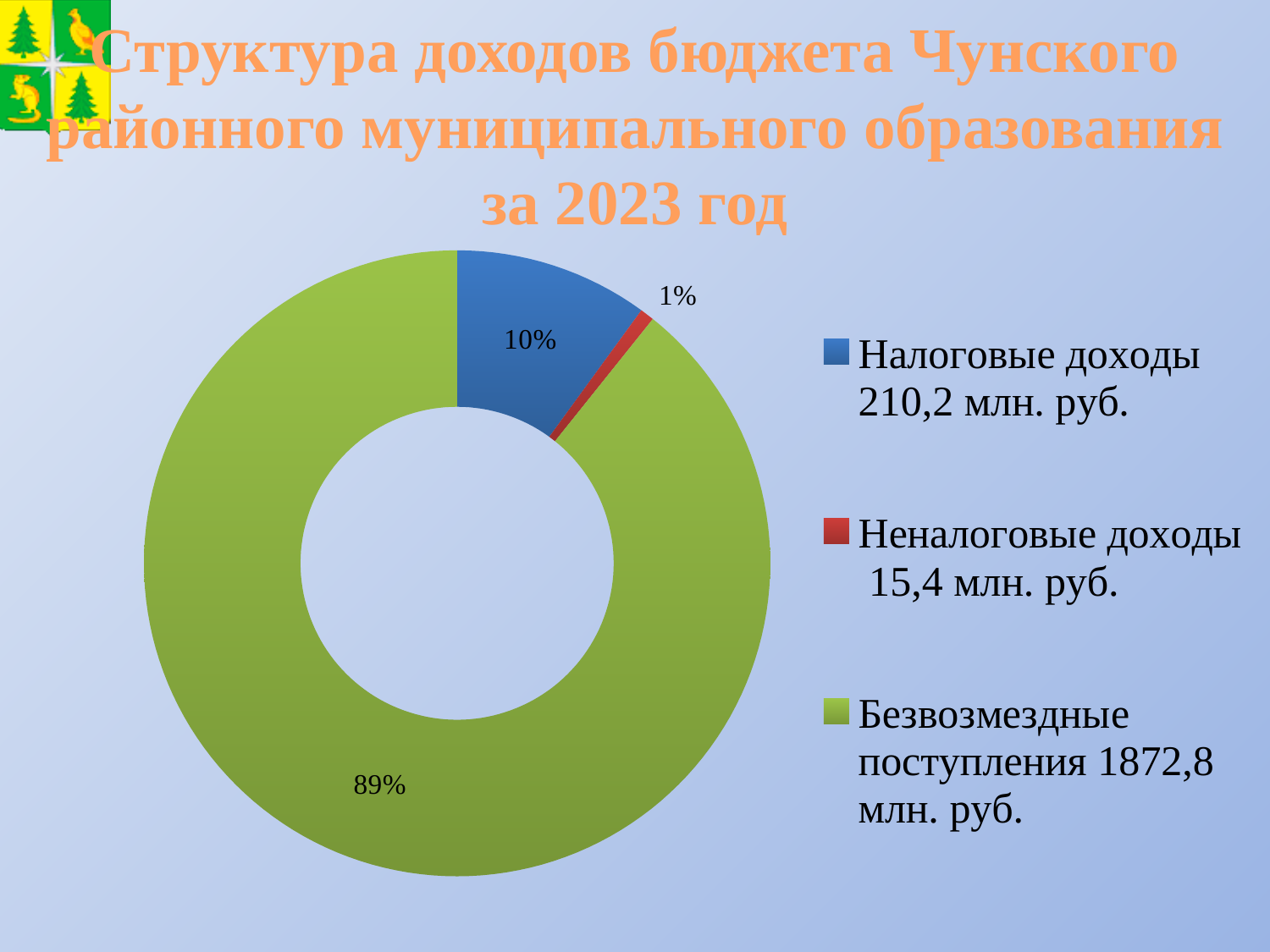
What kind of chart is shown on the slide? Doughnut (pie) chart What share of the chart is labelled for Налоговые доходы? 10% By how many percentage points does the share of Безвозмездные поступления exceed the share of Налоговые доходы? 79 percentage points Which category has the smallest share of the chart? Неналоговые доходы How many slices does the doughnut chart have? 3 What amount is given in the legend for Неналоговые доходы? 15,4 млн. руб. How many entries does the legend list? 3 Which category has the largest share of the chart? Безвозмездные поступления What amount is given in the legend for Налоговые доходы? 210,2 млн. руб. What share of the chart is labelled for Неналоговые доходы? 1% What share of the chart is labelled for Безвозмездные поступления? 89% What amount is given in the legend for Безвозмездные поступления? 1872,8 млн. руб.